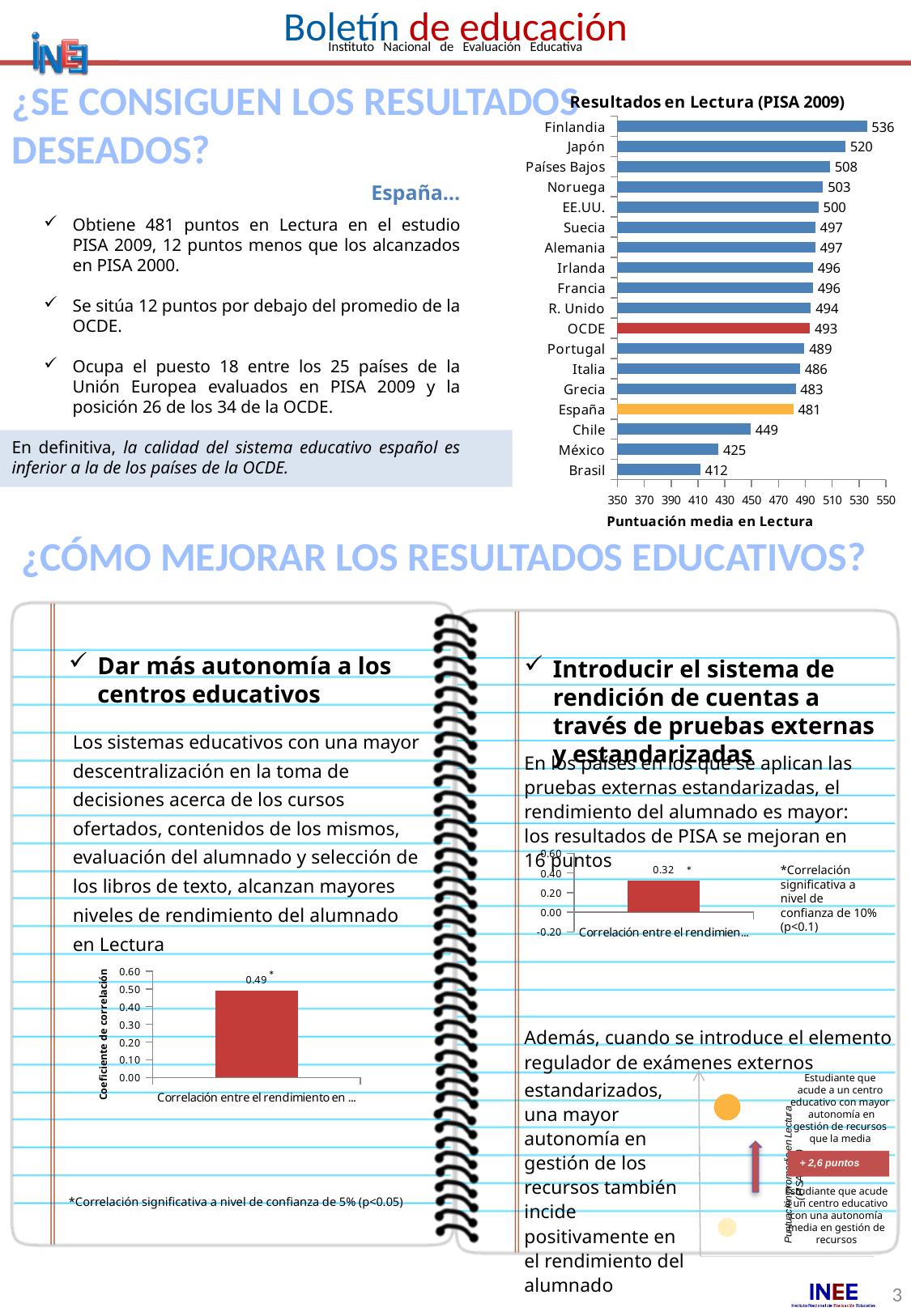
In the chart 'Resultados en Lectura (PISA 2009)', what is the value for España? 481 In the chart 'Resultados en Lectura (PISA 2009)', which country has the lowest score? Brasil How many bars are shown in the chart 'Resultados en Lectura (PISA 2009)'? 18 In the chart 'Resultados en Lectura (PISA 2009)', what is the value for México? 425 In the chart 'Resultados en Lectura (PISA 2009)', what is the difference between the OCDE value and the España value? 12 In the chart 'Resultados en Lectura (PISA 2009)', which has a higher score, Japón or Países Bajos? Japón In the small correlation bar chart on the right page of the notebook (under 'Introducir el sistema de rendición de cuentas'), what is the value of the bar? 0.32 In the chart 'Resultados en Lectura (PISA 2009)', what is the difference between Finlandia and Brasil? 124 What type of chart is 'Resultados en Lectura (PISA 2009)'? bar chart In the small correlation bar chart on the left page of the notebook (under 'Dar más autonomía a los centros educativos'), what is the value of the bar? 0.49 In the chart 'Resultados en Lectura (PISA 2009)', which country has the highest score? Finlandia What is the x-axis title of the chart 'Resultados en Lectura (PISA 2009)'? Puntuación media en Lectura